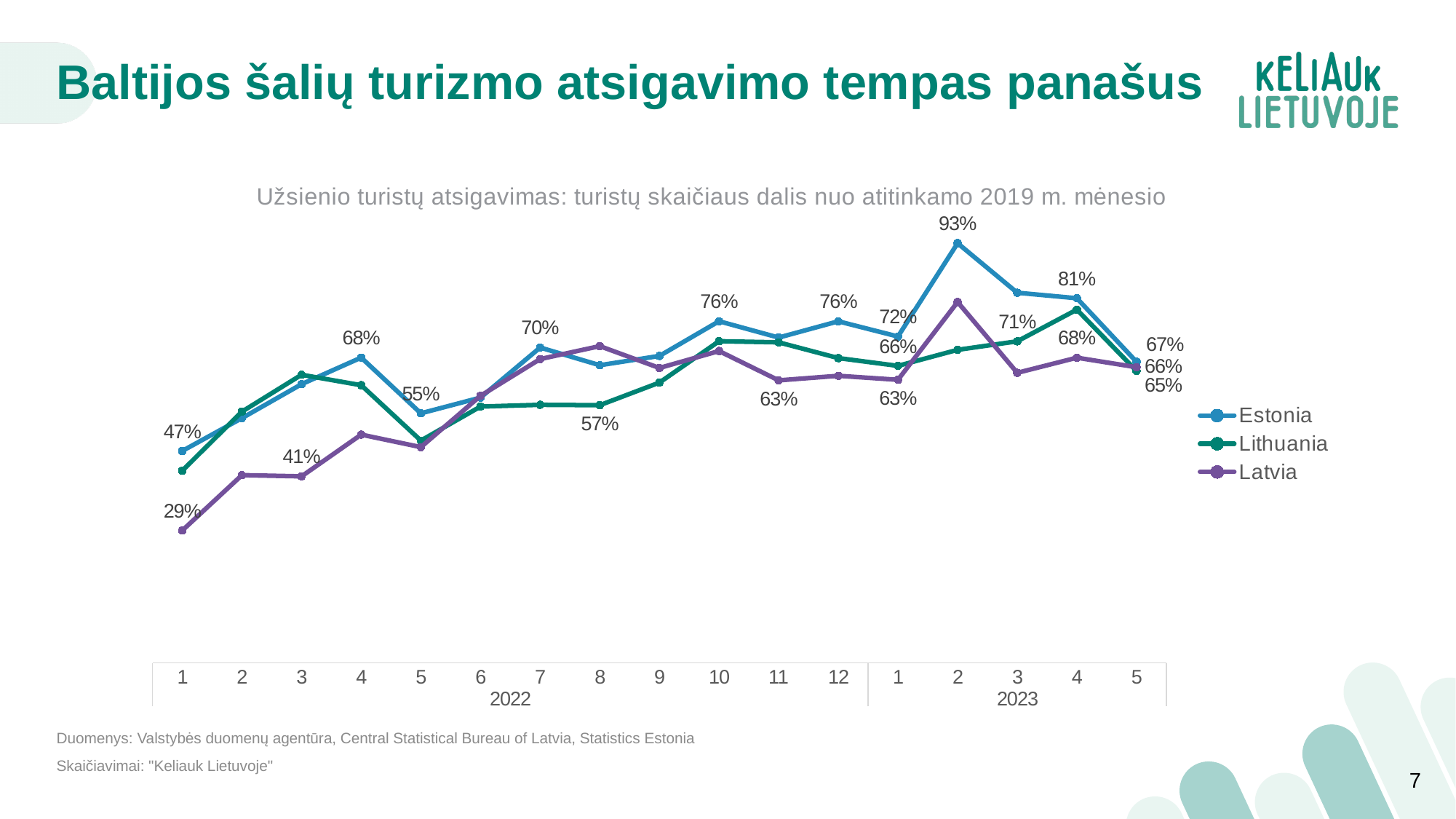
How many series does the legend list? 3 What kind of chart is shown on the slide? line chart What is the value for Lithuania in month 5 of 2023? 65% What is the value for Estonia in month 1 of 2022? 47% Which series reaches the highest value on the chart, and in which month? Estonia, month 2 of 2023 How many months are plotted along the x axis in total? 17 Which series has the lowest value in month 1 of 2022? Latvia Does the Latvia line generally rise or fall from month 1 of 2022 to month 4 of 2022? rise What is the value for Latvia in month 1 of 2022? 29% Which is larger in month 2 of 2023: the value for Estonia or the value for Lithuania? Estonia What is the value for Estonia in month 2 of 2023? 93% What is the difference between Estonia's value in month 1 of 2022 (47%) and Latvia's value in the same month (29%)? 18 percentage points